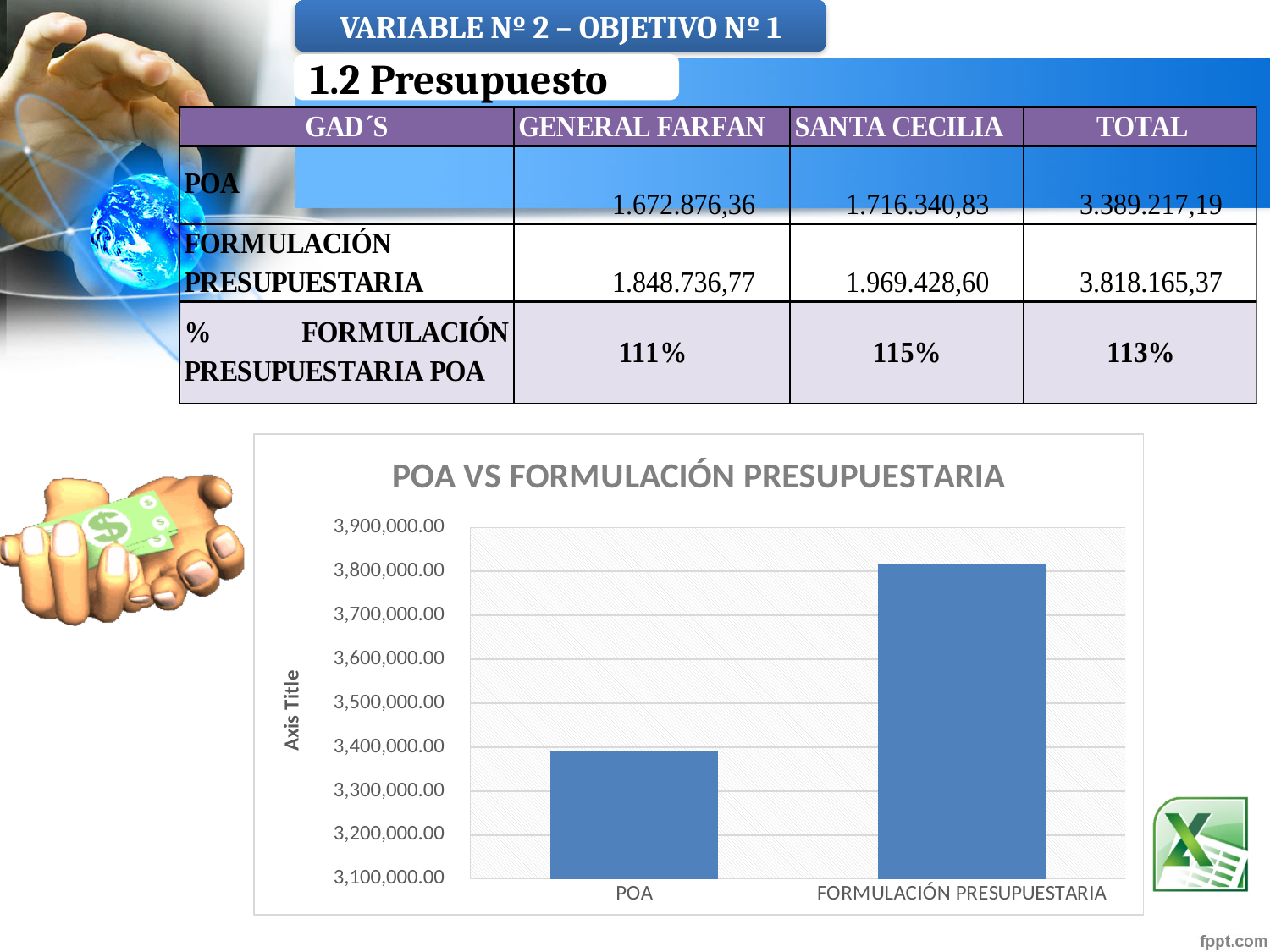
Is the value for POA greater or less than 3,400,000.00? less Which is larger in the chart, POA or FORMULACIÓN PRESUPUESTARIA? FORMULACIÓN PRESUPUESTARIA Is the value for POA greater or less than 3,300,000.00? greater Do the bar values rise or fall from POA to FORMULACIÓN PRESUPUESTARIA? rise What is the title of the chart? POA VS FORMULACIÓN PRESUPUESTARIA What label is shown on the vertical axis of the chart? Axis Title Which category has the lowest bar in the chart? POA What kind of chart is shown on the slide? bar chart How many bars are plotted in the chart? 2 Which category has the highest bar in the chart? FORMULACIÓN PRESUPUESTARIA Is the value for FORMULACIÓN PRESUPUESTARIA greater or less than 3,800,000.00? greater What is the lowest value shown on the vertical axis of the chart? 3,100,000.00